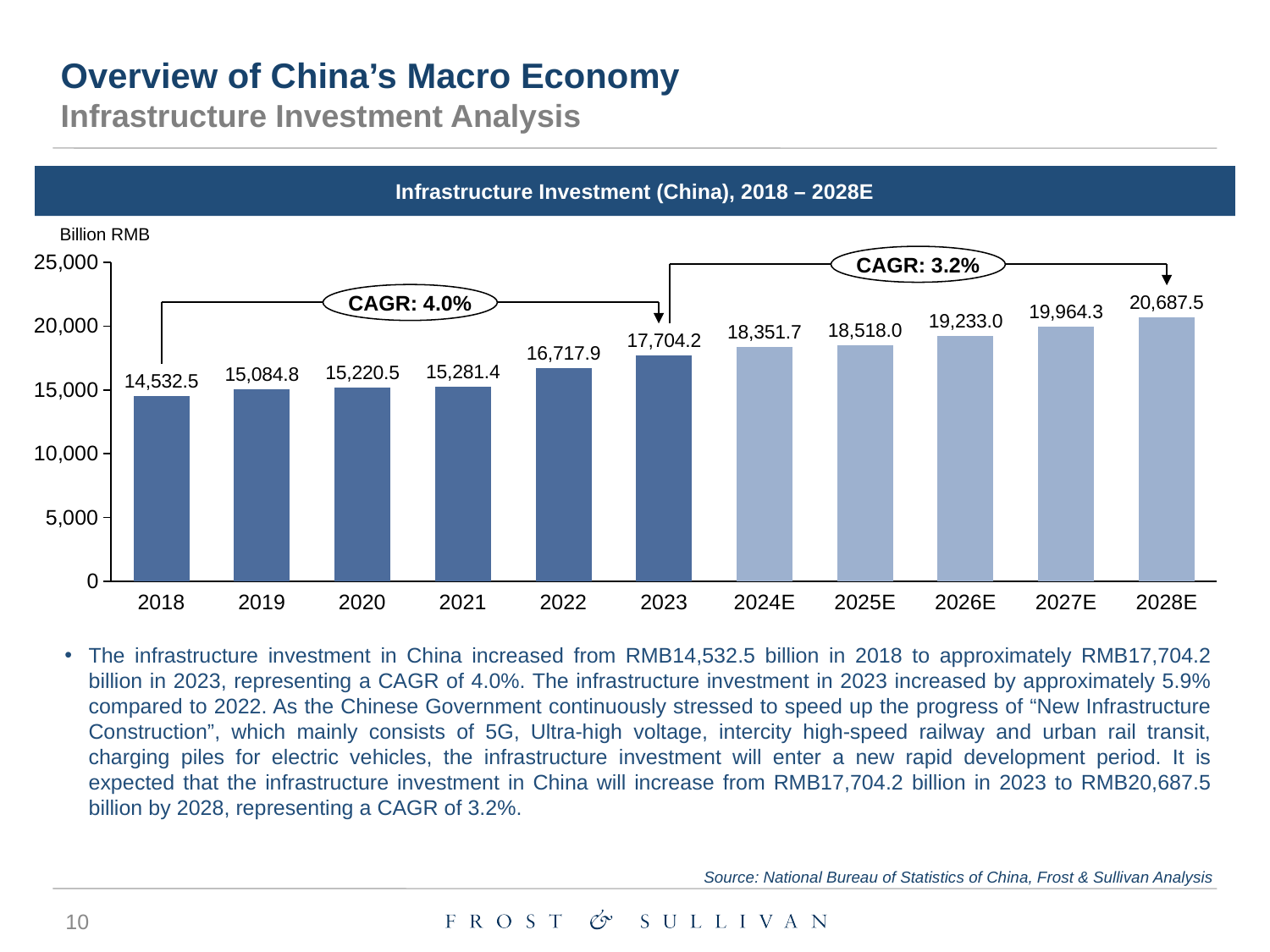
Which is larger, the value for 2025E or the value for 2024E? 2025E What is the infrastructure investment value for 2023? 17,704.2 Is the value for 2026E greater or less than 20,000? less What is the difference between the 2023 and 2022 infrastructure investment values? 986.3 Which year has the highest infrastructure investment value? 2028E Which year has the lowest infrastructure investment value? 2018 What kind of chart is shown? bar chart What is the infrastructure investment value for 2028E? 20,687.5 What is the infrastructure investment value for 2018? 14,532.5 How many years are shown on the x axis? 11 Do the values rise or fall from 2018 to 2028E? rise What CAGR is shown for the period 2023 to 2028E? 3.2%